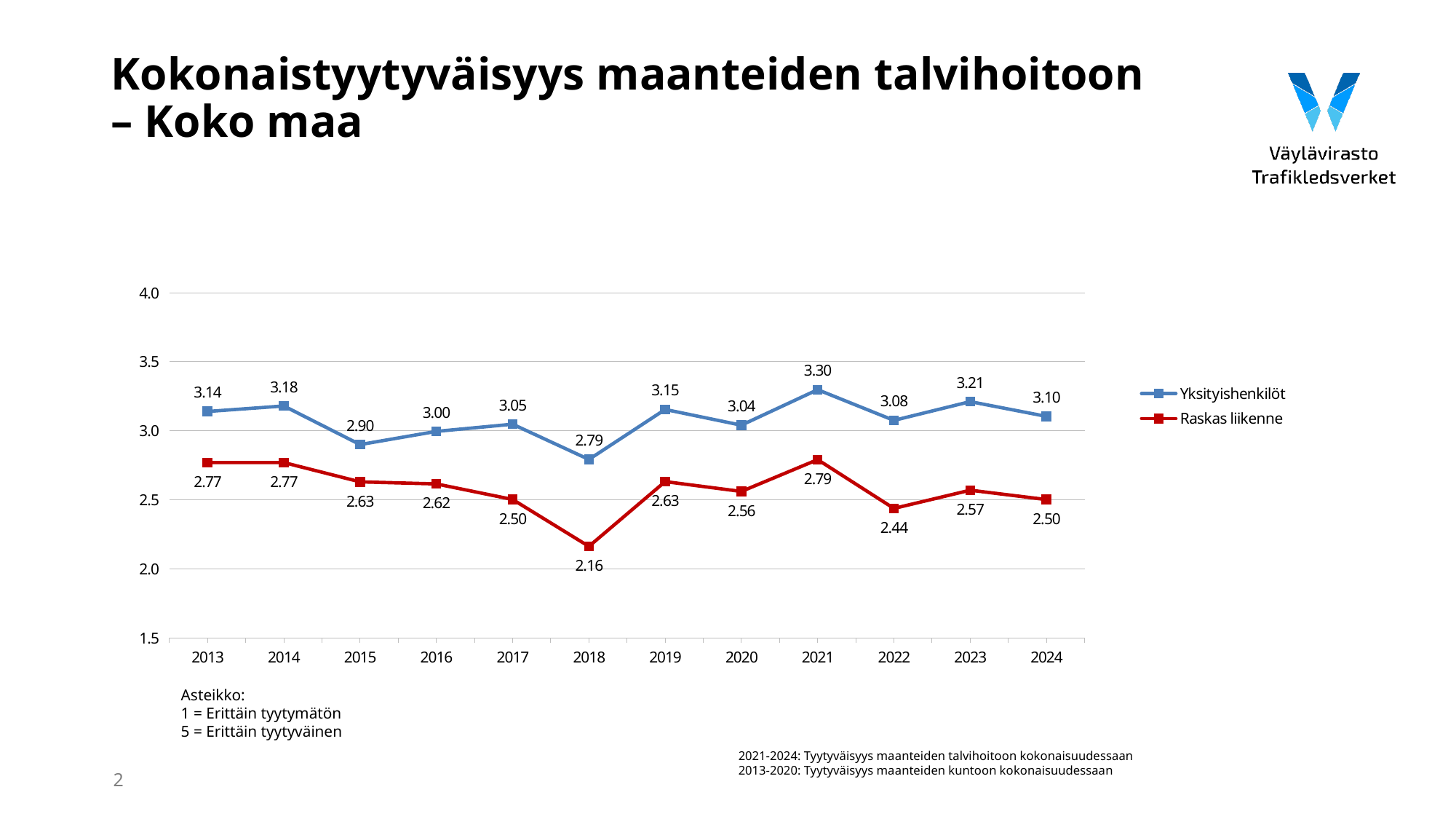
Which series has the higher value in 2022, Yksityishenkilöt or Raskas liikenne? Yksityishenkilöt What is the difference between Yksityishenkilöt and Raskas liikenne in 2018? 0.63 Is the value for Raskas liikenne in 2021 greater or less than 3.0? less How many years are shown on the x axis? 12 How many series does the legend list? 2 In which year is the Yksityishenkilöt series at its lowest? 2018 What is the value for Raskas liikenne in 2024? 2.50 In which year is the Raskas liikenne series at its highest? 2021 What is the value for Raskas liikenne in 2018? 2.16 What is the value for Yksityishenkilöt in 2021? 3.30 Did the Yksityishenkilöt value rise or fall from 2023 to 2024? fall What kind of chart is shown on the slide? line chart